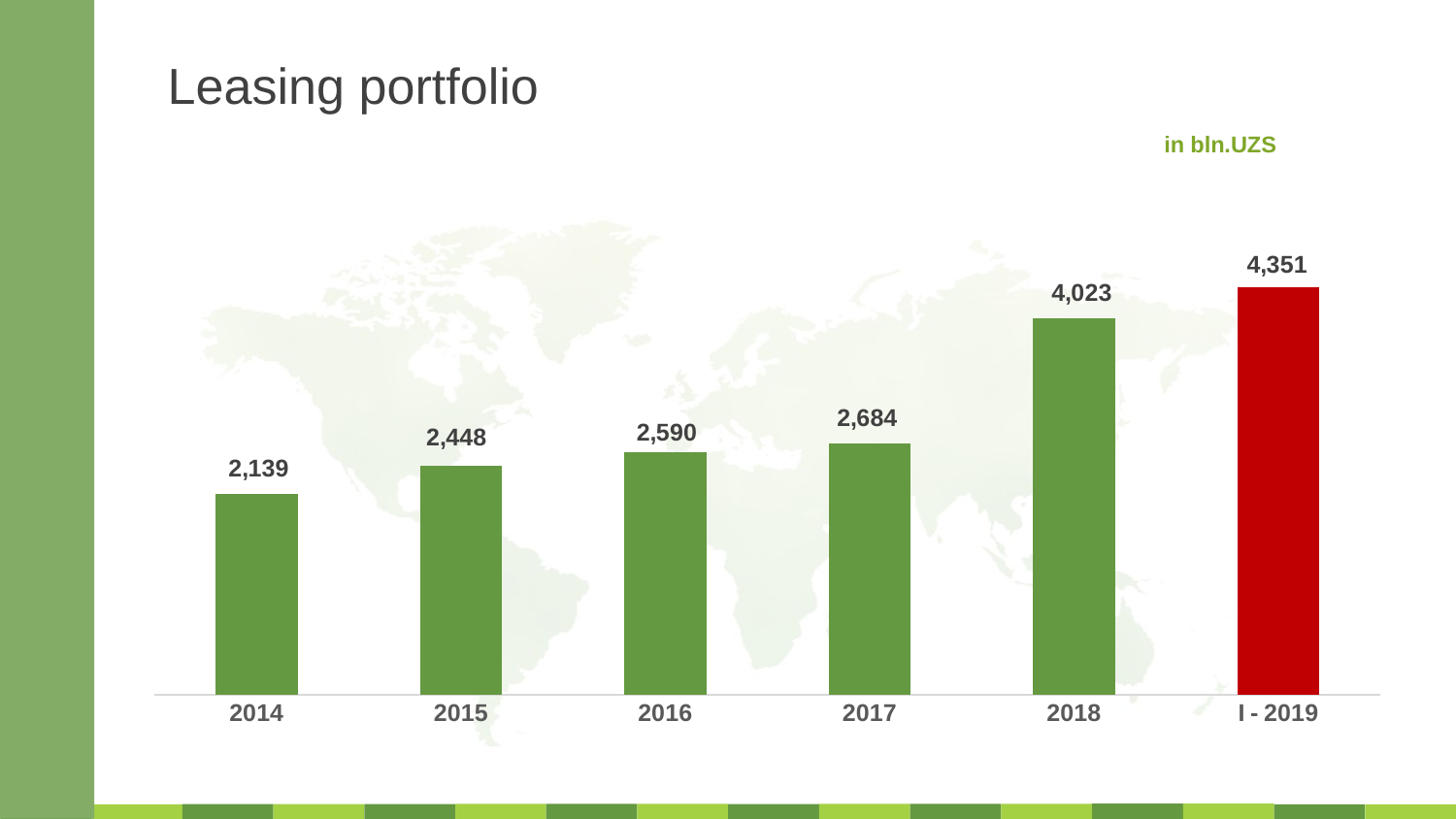
What is the difference between the leasing portfolio values for 2018 and 2017? 1,339 Which period has the highest leasing portfolio value? I - 2019 Which year has the lowest leasing portfolio value? 2014 Which is larger, the leasing portfolio value for 2015 or for 2016? 2016 What is the difference between the leasing portfolio values for 2016 and 2015? 142 How many periods are shown on the x axis of the chart? 6 Do the leasing portfolio values rise or fall from 2014 to I - 2019? Rise What is the leasing portfolio value for I - 2019? 4,351 What is the leasing portfolio value for 2017? 2,684 What is the leasing portfolio value for 2014? 2,139 What kind of chart is shown on the slide? Bar chart In what unit are the leasing portfolio values expressed? bln.UZS